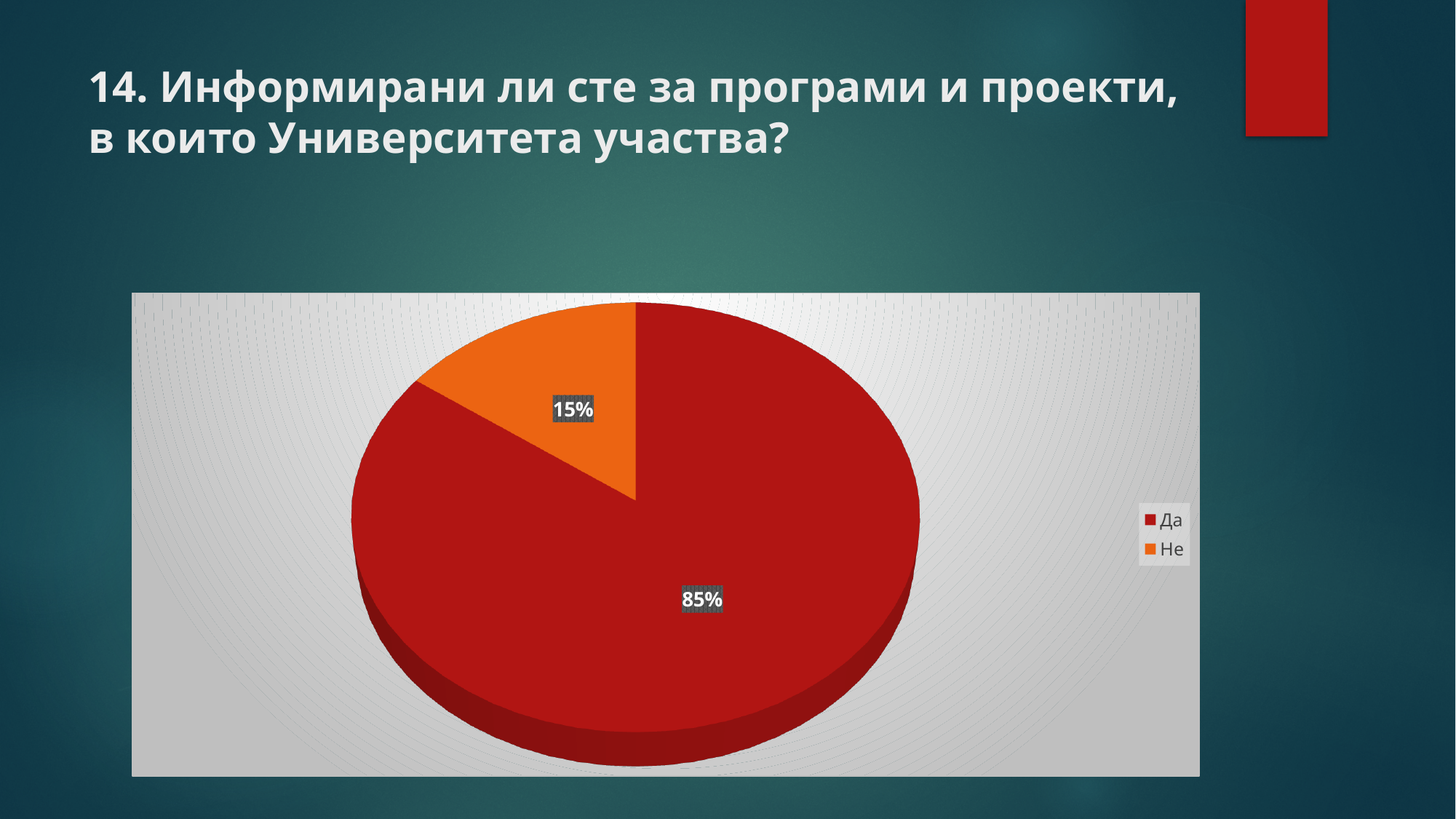
What percentage of the pie is labelled "Не"? 15% What is the difference in percentage points between the "Да" and "Не" slices? 70 What percentage of the pie is labelled "Да"? 85% Which category has the largest share of the pie? Да Which slice is larger, "Да" or "Не"? Да What share of the pie does the "Не" slice represent? 15% How many slices does the pie chart have? 2 What colour is the "Не" slice in the pie chart? orange What colour is the "Да" slice in the pie chart? red Which category has the smallest share of the pie? Не How many entries does the legend list? 2 What kind of chart is shown on the slide? pie chart